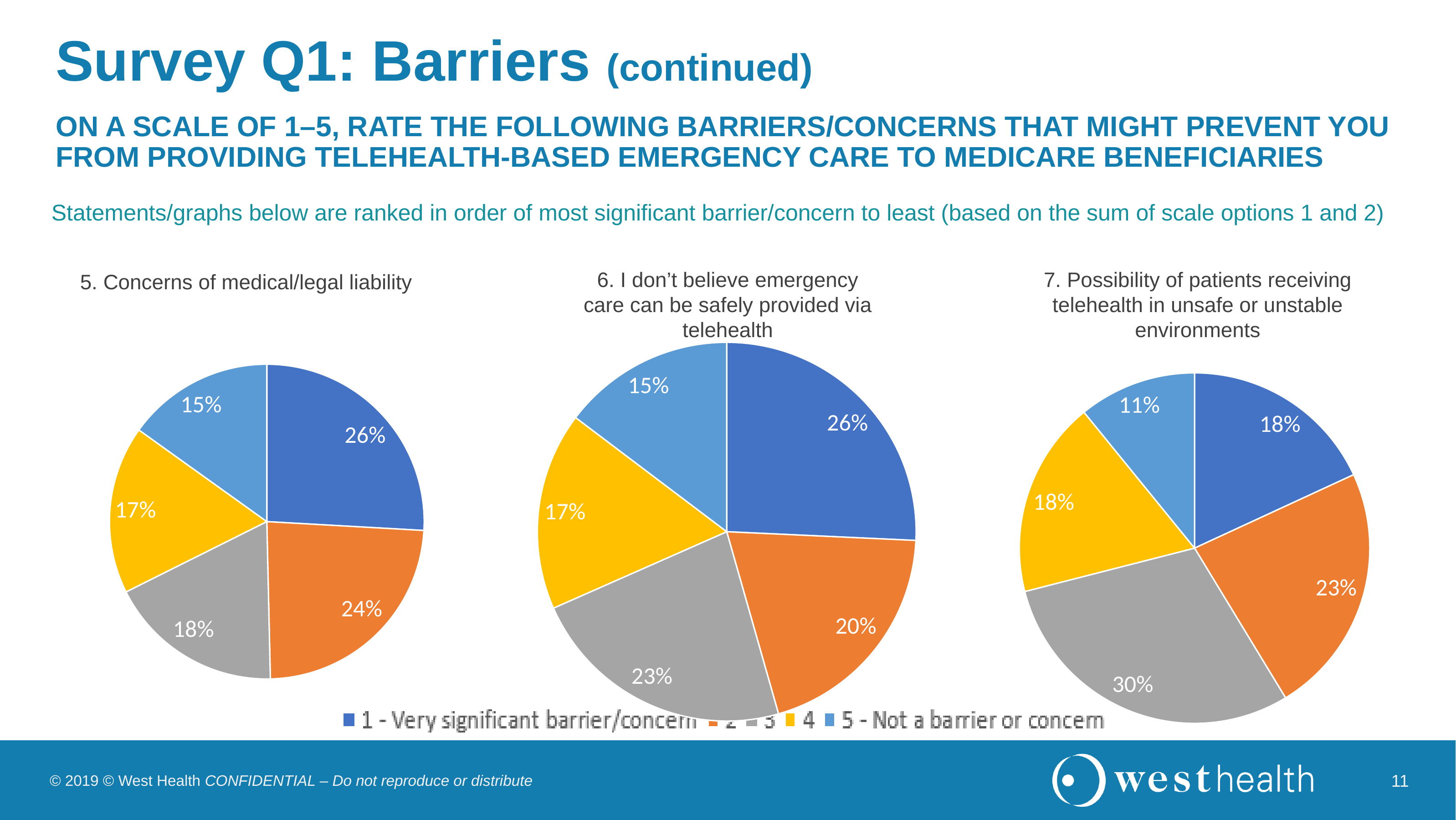
In the chart titled "5. Concerns of medical/legal liability", what is the difference in percentage points between the slices for option 1 and option 5? 11 What type of chart is used for "7. Possibility of patients receiving telehealth in unsafe or unstable environments"? pie chart In the chart titled "6. I don't believe emergency care can be safely provided via telehealth", what share of respondents chose option 3? 23% How many pie charts are shown on the slide? 3 In the chart titled "7. Possibility of patients receiving telehealth in unsafe or unstable environments", which scale option has the largest slice? 3 In the chart titled "5. Concerns of medical/legal liability", what share of respondents chose "5 - Not a barrier or concern"? 15% In the chart titled "7. Possibility of patients receiving telehealth in unsafe or unstable environments", which scale option has the smallest slice? 5 - Not a barrier or concern How many slices does the chart titled "5. Concerns of medical/legal liability" have? 5 In the chart titled "7. Possibility of patients receiving telehealth in unsafe or unstable environments", what share of respondents chose option 2? 23% In the chart titled "6. I don't believe emergency care can be safely provided via telehealth", which is larger: the slice for option 2 or the slice for option 3? option 3 In the chart titled "5. Concerns of medical/legal liability", what share of respondents chose "1 - Very significant barrier/concern"? 26% In the chart titled "6. I don't believe emergency care can be safely provided via telehealth", which scale option has the largest slice? 1 - Very significant barrier/concern